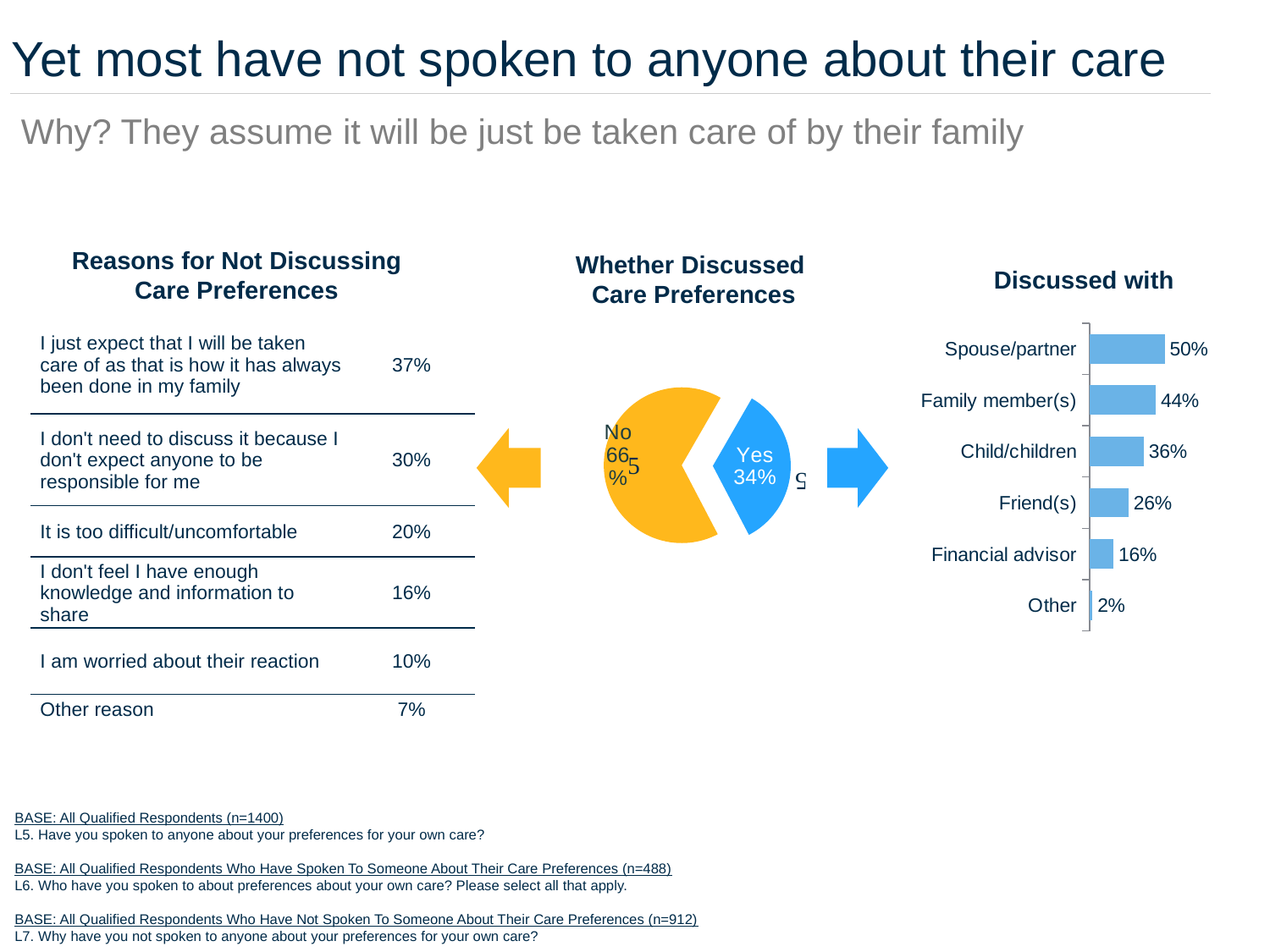
In the 'Whether Discussed Care Preferences' chart, what share of respondents answered No? 66% In the 'Discussed with' chart, which is larger: Friend(s) or Financial advisor? Friend(s) In the 'Whether Discussed Care Preferences' chart, which slice is larger: Yes or No? No In the 'Whether Discussed Care Preferences' chart, what share of respondents answered Yes? 34% What type of chart is 'Discussed with'? Bar chart In the 'Discussed with' chart, what is the value for Financial advisor? 16% In the 'Discussed with' chart, what is the value for Spouse/partner? 50% In the 'Discussed with' chart, which category has the lowest value? Other In the 'Discussed with' chart, which category has the highest value? Spouse/partner What type of chart is 'Whether Discussed Care Preferences'? Pie chart In the 'Discussed with' chart, what is the difference between Family member(s) and Child/children? 8% How many categories are shown in the 'Discussed with' chart? 6